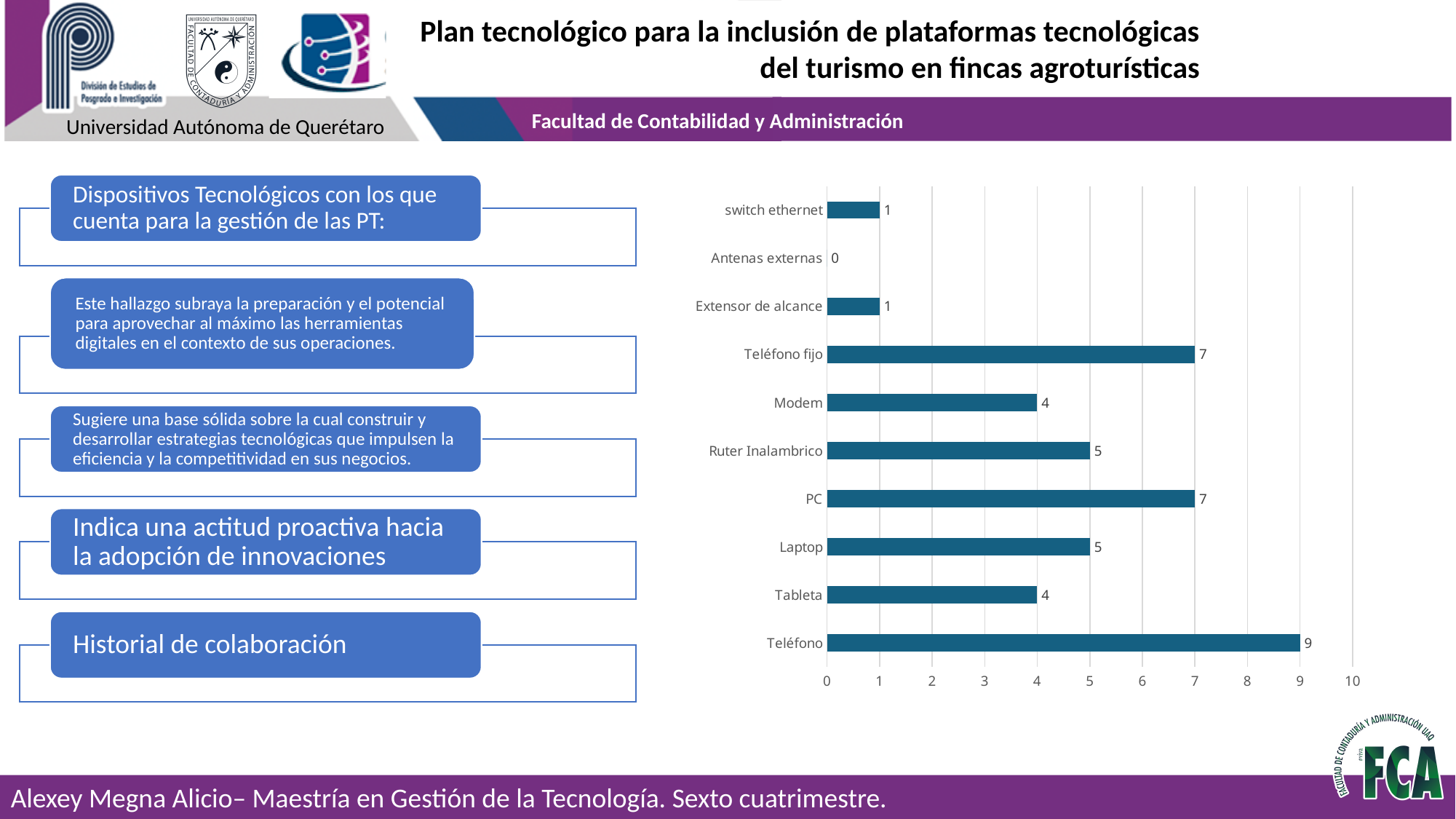
Which is larger, the value for PC or the value for Laptop? PC Which category has the lowest value? Antenas externas Which category has the highest value? Teléfono What is the maximum value shown on the x axis? 10 What is the value for Teléfono? 9 Is the value for Teléfono fijo greater or less than 5? greater How many categories are shown on the chart? 10 What kind of chart is shown on the slide? bar chart What is the value for Modem? 4 What is the value for switch ethernet? 1 What is the difference between the values for Teléfono and Tableta? 5 What is the value for Ruter Inalambrico? 5